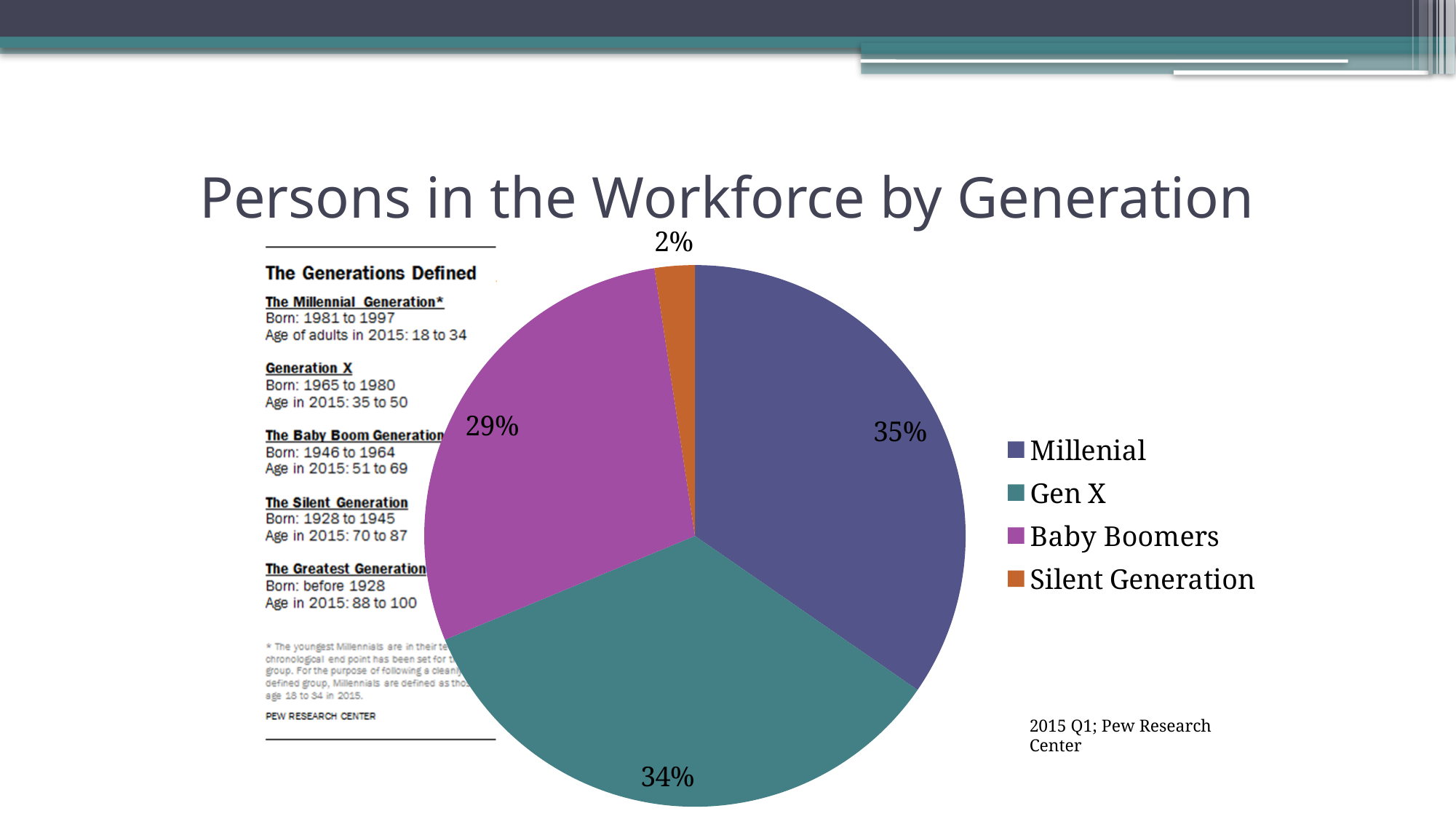
Which has a larger share of the workforce, Gen X or Baby Boomers? Gen X What share of the workforce is the Silent Generation? 2% What share of the workforce is Gen X? 34% What share of the workforce is Baby Boomers? 29% What is the difference in percentage points between the Millenial share and the Baby Boomers share? 6 Which generation has the smallest share of the workforce? Silent Generation Which generation has the largest share of the workforce? Millenial What is the title of the chart? Persons in the Workforce by Generation What kind of chart is shown on the slide? Pie chart What share of the workforce is Millenial? 35% How many generations are shown in the pie chart? 4 What is the difference in percentage points between the Baby Boomers share and the Silent Generation share? 27